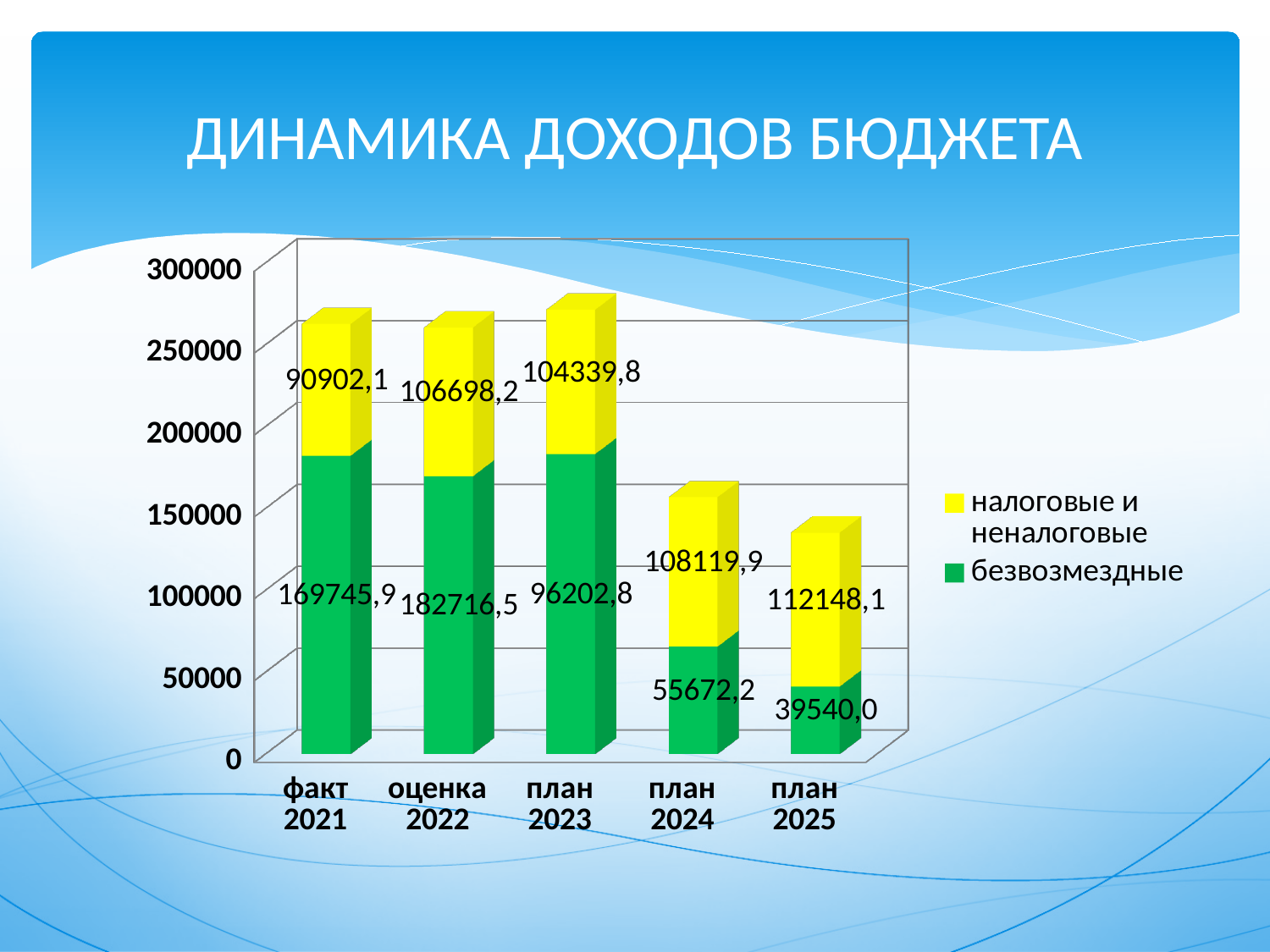
What is the value of безвозмездные for оценка 2022? 182716,5 How many categories are shown on the x axis of the chart? 5 What is the total of the stacked bar for факт 2021? 260648,0 What is the value of безвозмездные for план 2024? 55672,2 What is the difference between the безвозмездные values for план 2024 and план 2025? 16132,2 Which category has the highest value for налоговые и неналоговые? план 2025 What kind of chart is shown on the slide? Stacked bar chart What is the value of налоговые и неналоговые for факт 2021? 90902,1 What is the value of налоговые и неналоговые for план 2025? 112148,1 Which category has the lowest value for безвозмездные? план 2025 How many series does the legend list? 2